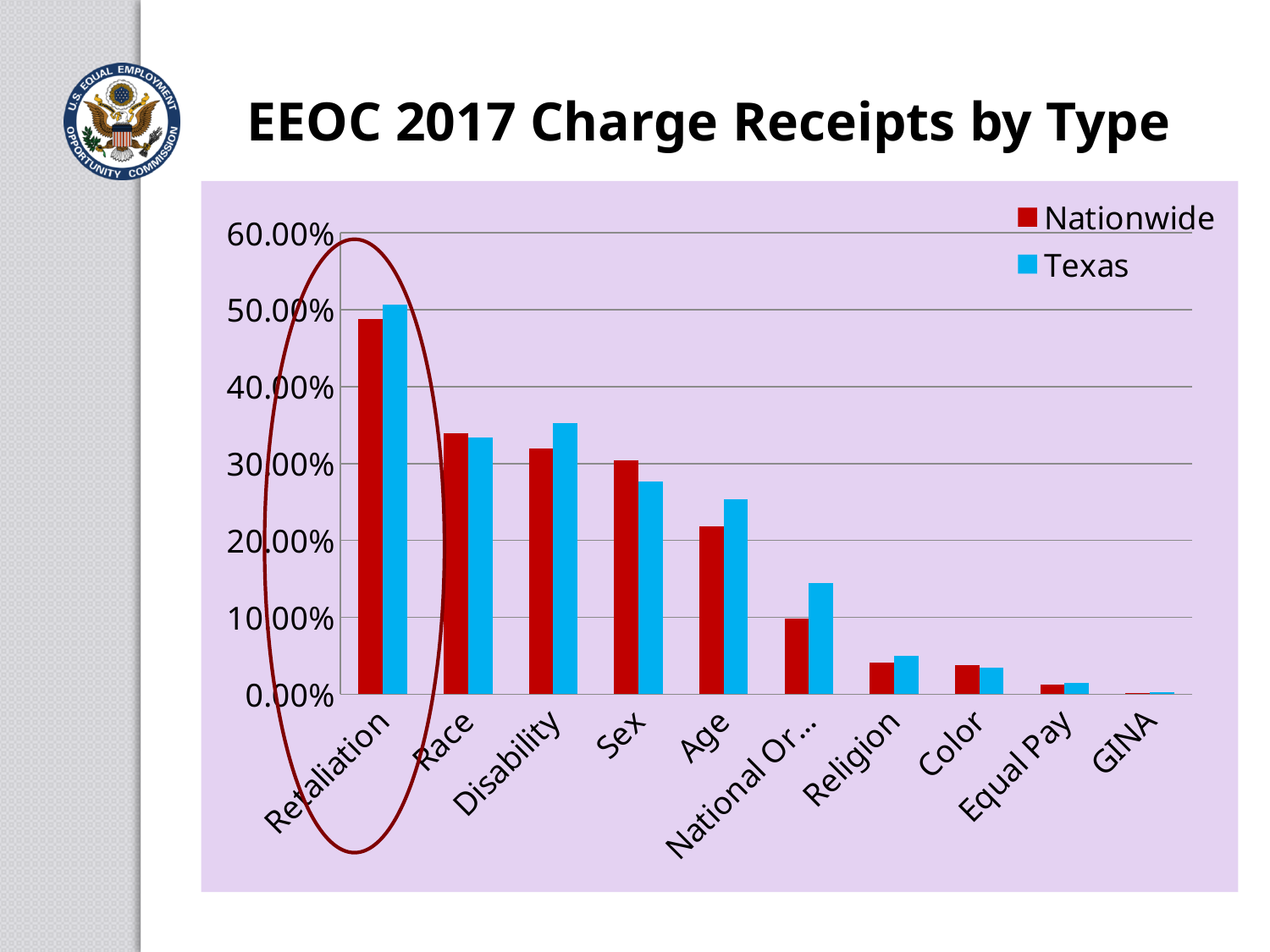
How many series does the legend list? 2 Which charge type has the lowest Texas value? GINA Do the Nationwide values generally rise or fall moving from Retaliation to GINA along the x axis? fall For Sex, which series has the larger value, Nationwide or Texas? Nationwide What kind of chart is shown on the slide? bar chart Is the Texas value for Age greater or less than 20.00%? greater How many charge type categories are shown on the x axis? 10 For Disability, which series has the larger value, Nationwide or Texas? Texas Is the Texas value for Sex greater or less than 30.00%? less Is the Nationwide value for Retaliation greater or less than 40.00%? greater Which charge type has the highest Nationwide value? Retaliation